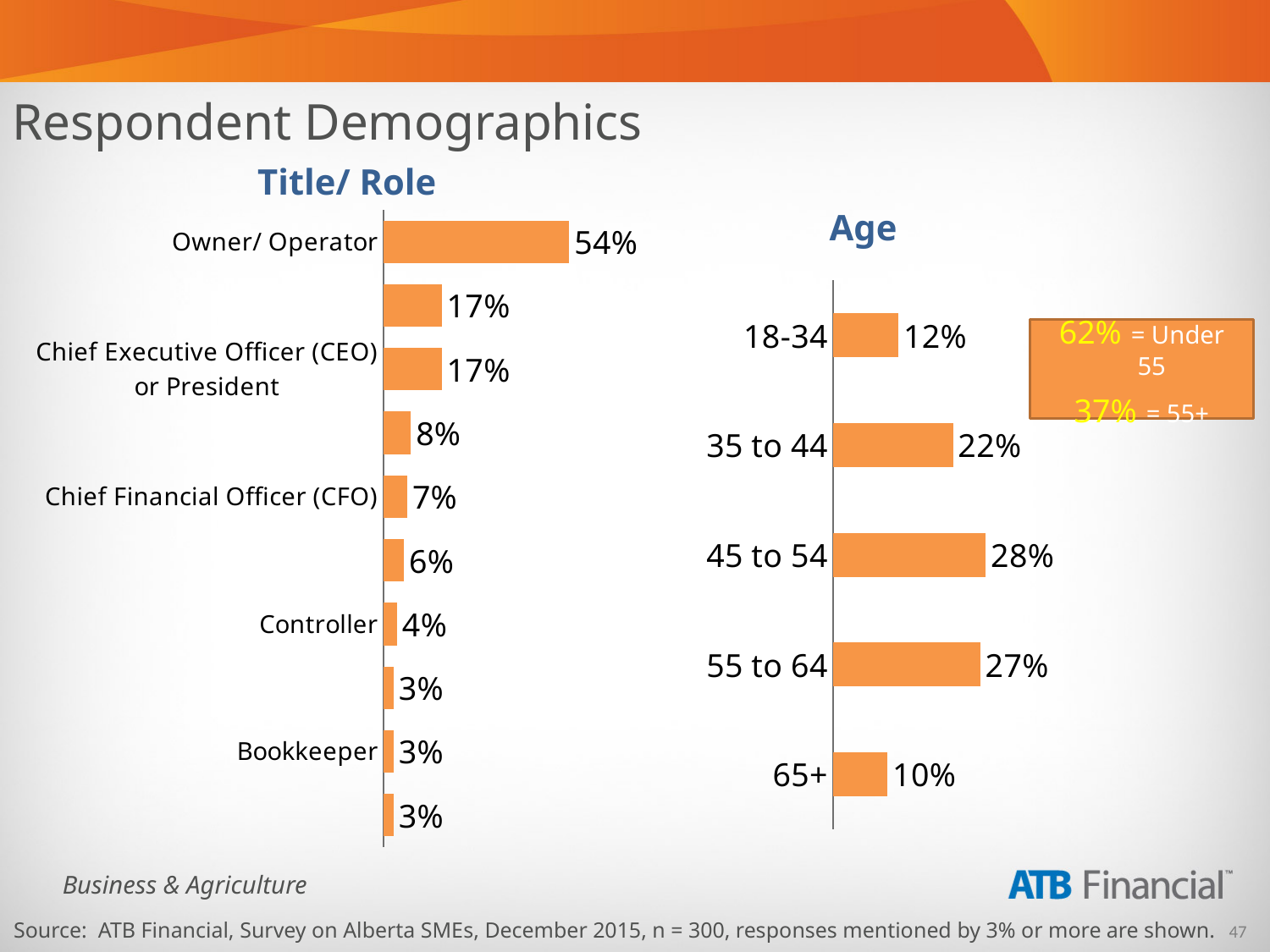
What type of chart is the Title/ Role chart? Bar chart In the Age chart, what percentage of respondents are aged 65+? 10% How many age groups are shown in the Age chart? 5 In the Title/ Role chart, what percentage of respondents are Owner/ Operator? 54% In the Age chart, which age group has the highest percentage? 45 to 54 In the Age chart, what percentage of respondents are aged 45 to 54? 28% In the Age chart, which is larger: the 55 to 64 group or the 35 to 44 group? 55 to 64 In the Age chart, which age group has the lowest percentage? 65+ How many bars are plotted in the Title/ Role chart? 10 In the Title/ Role chart, which role has the highest percentage? Owner/ Operator In the Age chart, what percentage of respondents are aged 18-34? 12% In the Age chart, what is the difference between the 35 to 44 and 18-34 percentages? 10%